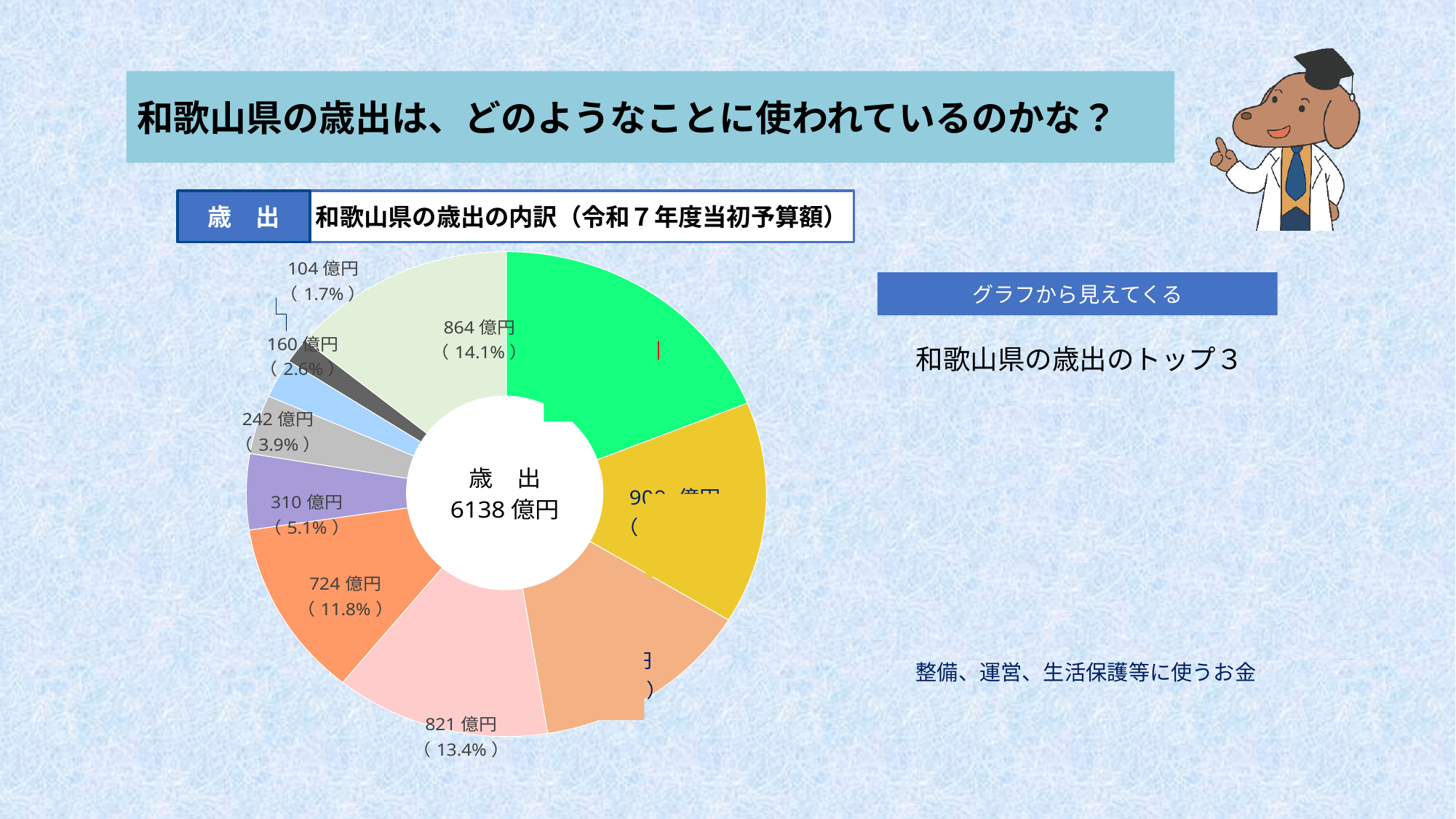
Which is larger, the pink slice (821 億円) or the orange slice (724 億円)? The pink slice (821 億円) What is the value of the purple slice of the pie chart? 310 億円 Which labelled slice has the smallest value in the pie chart? The dark gray slice, 104 億円 (1.7%) What is the value of the orange slice of the pie chart? 724 億円 What share of the pie does the light blue slice (160 億円) represent? 2.6% What share of the pie does the pink slice (821 億円) represent? 13.4% What total amount is shown in the centre of the pie chart? 6138 億円 What kind of chart is shown on the slide? Pie chart What is the title of the chart? 和歌山県の歳出の内訳（令和７年度当初予算額） What is the difference between the pink slice (821 億円) and the orange slice (724 億円)? 97 億円 What is the value of the pink slice of the pie chart? 821 億円